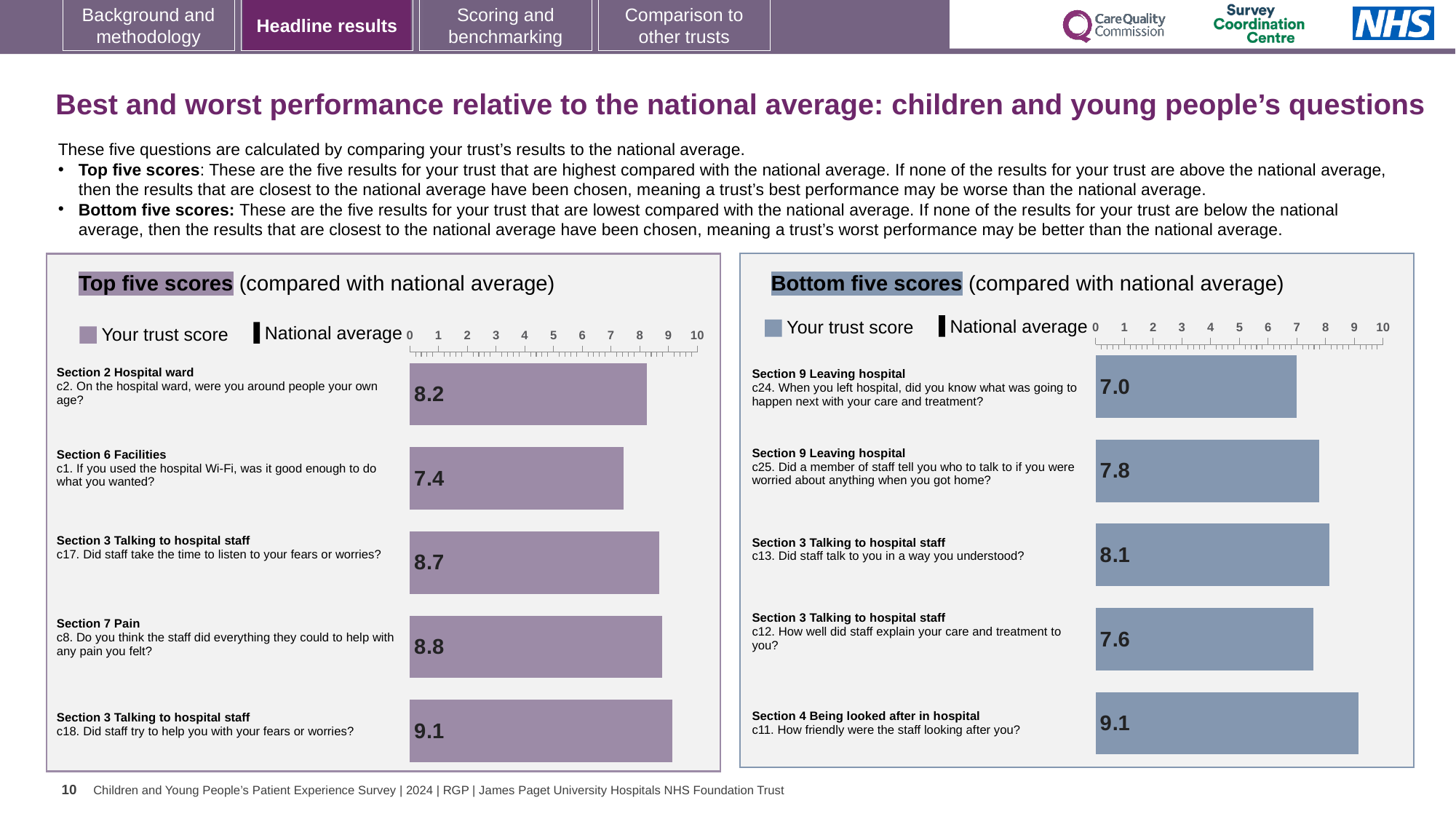
In the Bottom five scores chart, which question has the lowest trust score? c24. When you left hospital, did you know what was going to happen next with your care and treatment? In the Top five scores chart, what is the difference between the scores for c18 and c1? 1.7 In the Top five scores chart, what is the trust score for c2 'On the hospital ward, were you around people your own age?' 8.2 In the Bottom five scores chart, which question has the highest trust score? c11. How friendly were the staff looking after you? In the Bottom five scores chart, what is the difference between the scores for c11 and c24? 2.1 In the Bottom five scores chart, what is the trust score for c13 'Did staff talk to you in a way you understood?' 8.1 In the Top five scores chart, what is the trust score for c1 about the hospital Wi-Fi? 7.4 In the Bottom five scores chart, what is the trust score for c24 'When you left hospital, did you know what was going to happen next with your care and treatment?' 7.0 What kind of chart is the Top five scores chart? Bar chart In the Bottom five scores chart, which has the larger trust score: c25 or c12? c25 In the Top five scores chart, which question has the highest trust score? c18. Did staff try to help you with your fears or worries? In the Top five scores chart, which question has the lowest trust score? c1. If you used the hospital Wi-Fi, was it good enough to do what you wanted?